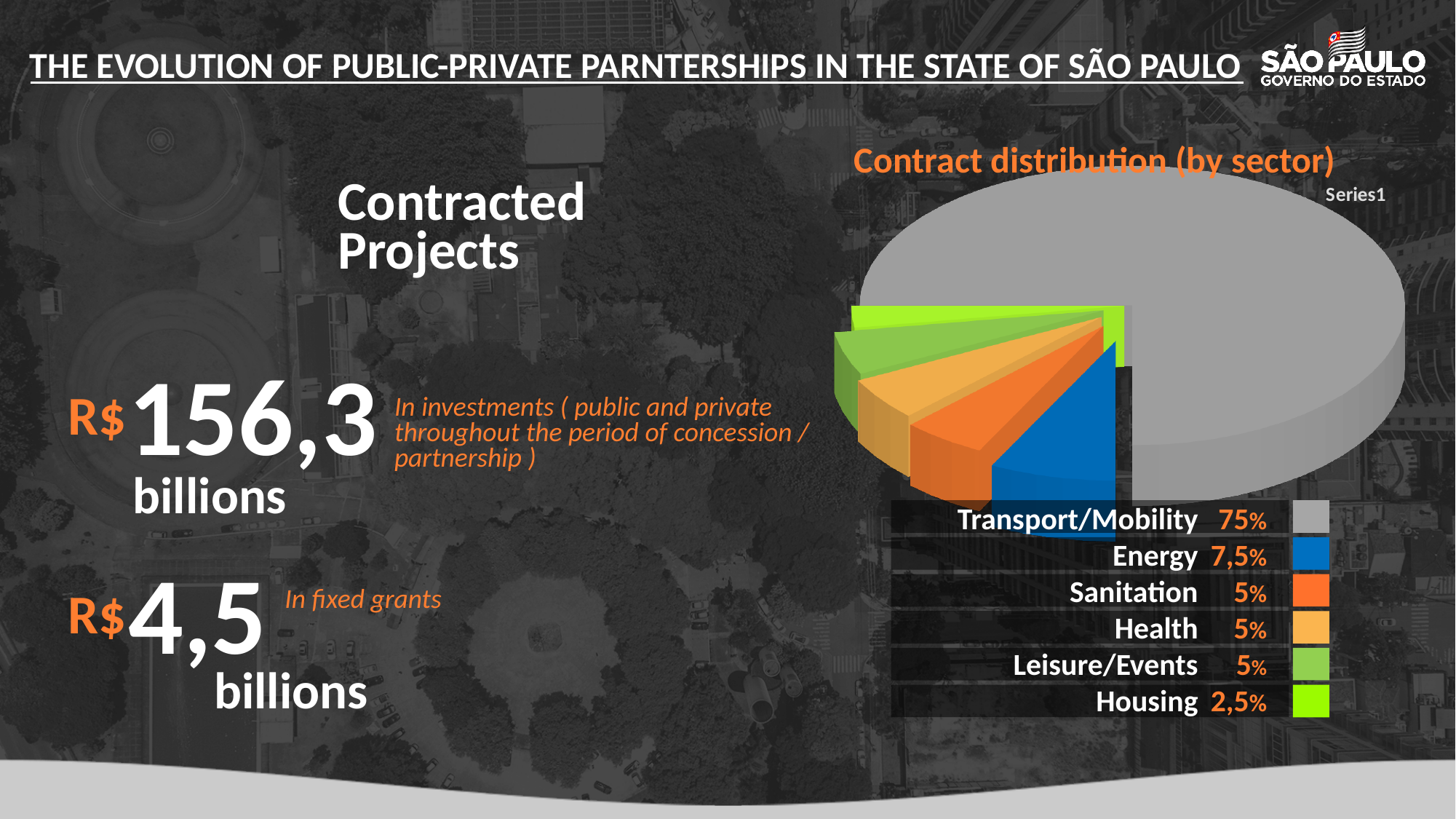
Which has a larger share in the pie chart, Energy or Housing? Energy What share of contracts does Housing hold in the pie chart? 2,5% What colour is the Energy slice in the pie chart? blue What is the difference between the Transport/Mobility share and the Energy share in the pie chart? 67,5% What kind of chart is shown under the title "Contract distribution (by sector)"? pie chart What share of contracts does Energy hold in the pie chart? 7,5% How many sectors are listed in the pie chart's legend? 6 What is the title of the pie chart? Contract distribution (by sector) Which sector has the smallest share in the pie chart? Housing Which sector has the largest share in the pie chart? Transport/Mobility What share of contracts does Transport/Mobility hold in the pie chart? 75% What share of contracts does Sanitation hold in the pie chart? 5%